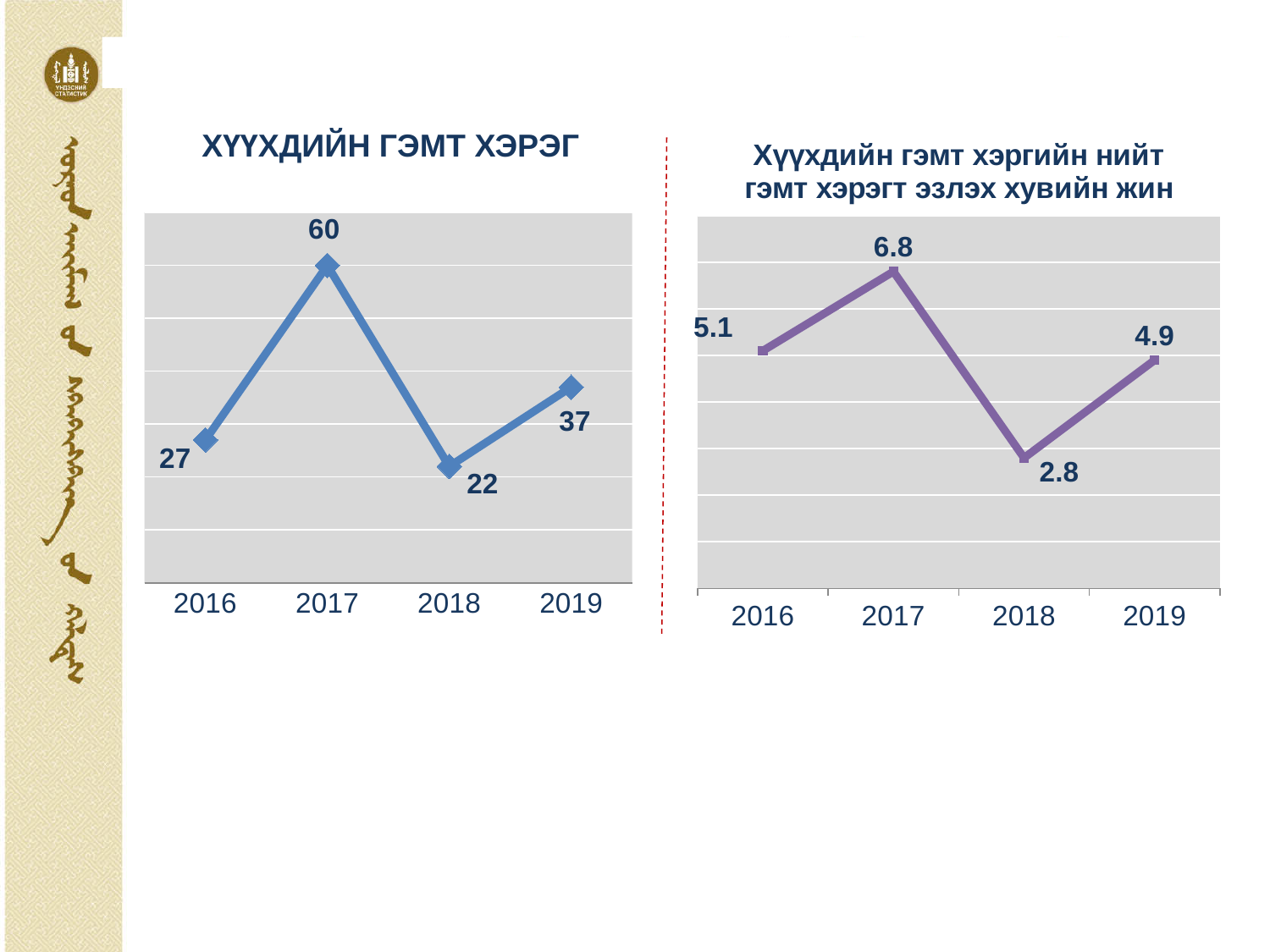
In the left chart titled 'ХҮҮХДИЙН ГЭМТ ХЭРЭГ', what is the value for 2019? 37 In the left chart titled 'ХҮҮХДИЙН ГЭМТ ХЭРЭГ', what is the difference between the values for 2017 and 2016? 33 In the left chart titled 'ХҮҮХДИЙН ГЭМТ ХЭРЭГ', how many data points are plotted? 4 In the right chart titled 'Хүүхдийн гэмт хэргийн нийт гэмт хэрэгт эзлэх хувийн жин', what is the value for 2016? 5.1 In the left chart titled 'ХҮҮХДИЙН ГЭМТ ХЭРЭГ', which year has the lowest value? 2018 In the right chart titled 'Хүүхдийн гэмт хэргийн нийт гэмт хэрэгт эзлэх хувийн жин', does the value rise or fall from 2018 to 2019? Rise In the left chart titled 'ХҮҮХДИЙН ГЭМТ ХЭРЭГ', what is the value for 2017? 60 What type of chart is the left chart titled 'ХҮҮХДИЙН ГЭМТ ХЭРЭГ'? Line chart In the right chart titled 'Хүүхдийн гэмт хэргийн нийт гэмт хэрэгт эзлэх хувийн жин', what is the value for 2018? 2.8 In the right chart titled 'Хүүхдийн гэмт хэргийн нийт гэмт хэрэгт эзлэх хувийн жин', which year has the highest value? 2017 In the right chart titled 'Хүүхдийн гэмт хэргийн нийт гэмт хэрэгт эзлэх хувийн жин', what is the difference between the values for 2017 and 2018? 4 In the right chart titled 'Хүүхдийн гэмт хэргийн нийт гэмт хэрэгт эзлэх хувийн жин', is the value for 2016 or 2019 larger? 2016